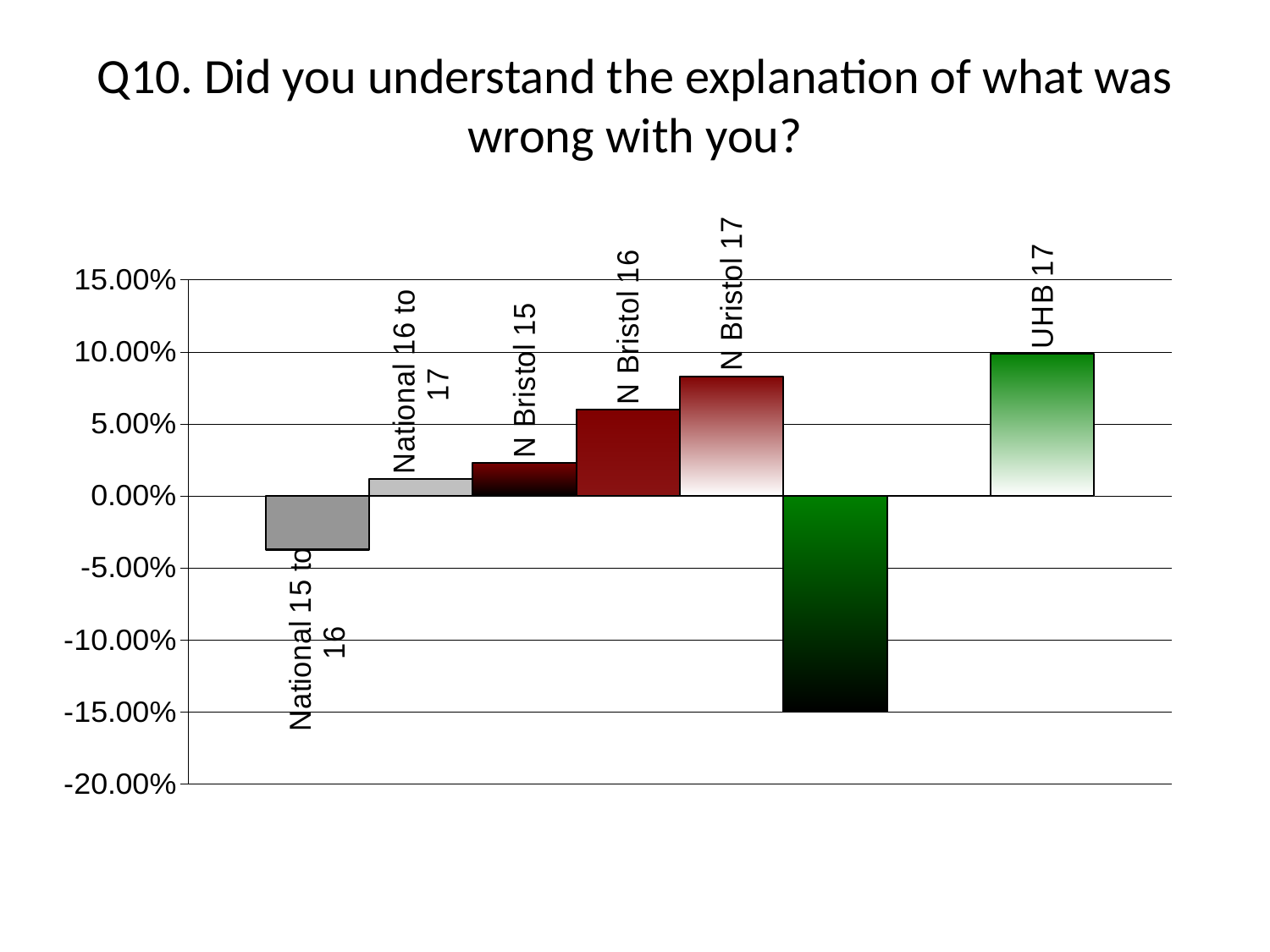
Is the value for N Bristol 15 greater or less than 5.00%? less Is the value for N Bristol 16 greater or less than 5.00%? greater Which labelled category has the highest value? UHB 17 Which is larger, the value for N Bristol 16 or the value for N Bristol 15? N Bristol 16 Which is larger, the value for National 15 to 16 or the value for National 16 to 17? National 16 to 17 What is the title of the chart? Q10. Did you understand the explanation of what was wrong with you? Is the value for UHB 17 greater or less than 5.00%? greater Do the values rise or fall across N Bristol 15, N Bristol 16 and N Bristol 17? rise What kind of chart is shown on the slide? bar chart